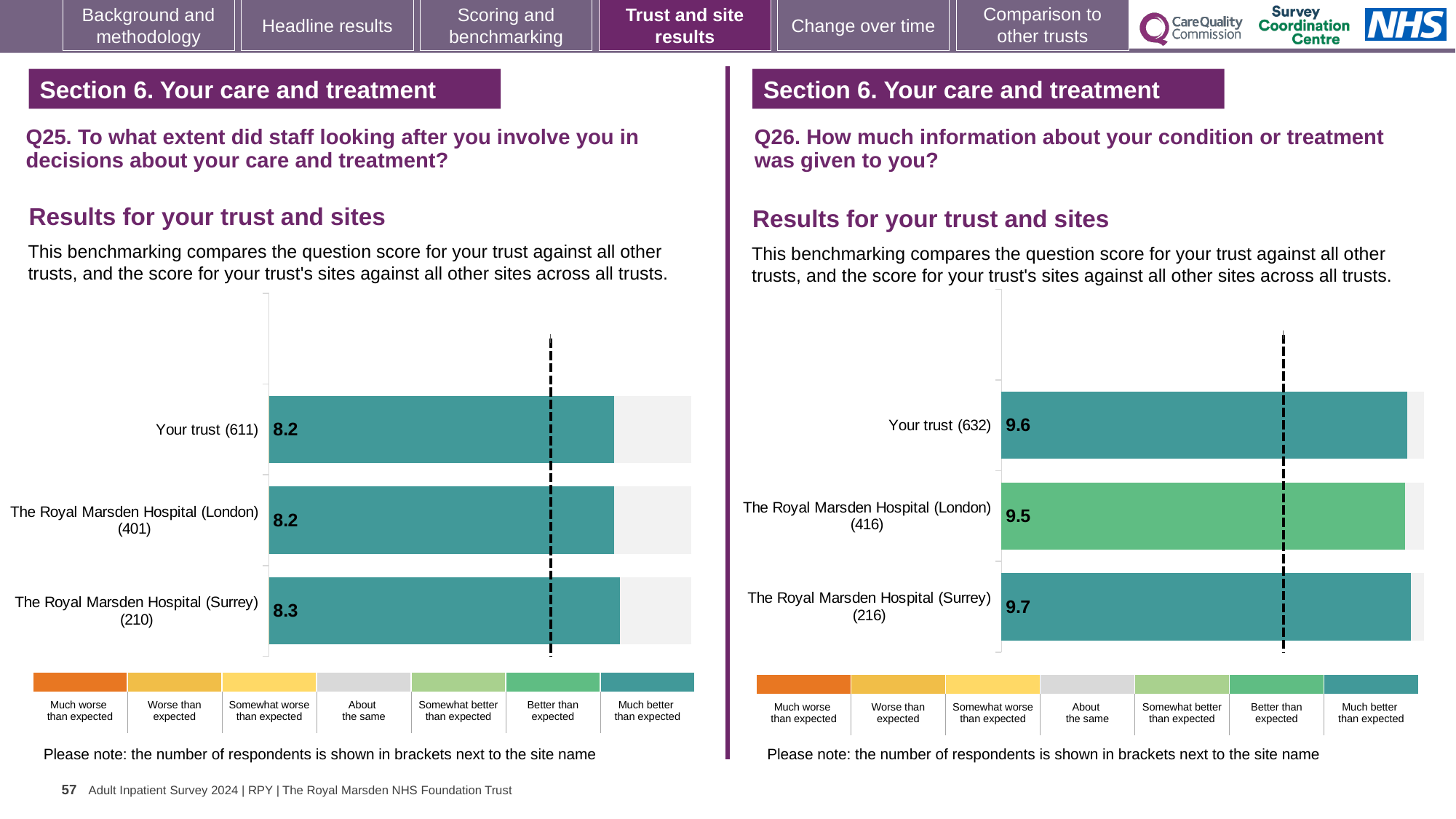
In the Q25 chart on the left, what is the score for Your trust (611)? 8.2 In the Q25 chart on the left, which has the higher score: The Royal Marsden Hospital (Surrey) or The Royal Marsden Hospital (London)? The Royal Marsden Hospital (Surrey) In the Q26 chart on the right, what is the score for Your trust (632)? 9.6 In the Q25 chart on the left, what is the difference between the scores for The Royal Marsden Hospital (Surrey) and Your trust? 0.1 In the Q26 chart on the right, what is the score for The Royal Marsden Hospital (London) (416)? 9.5 What type of chart is used for the Q26 results on the right? Bar chart In the Q25 chart on the left, what is the score for The Royal Marsden Hospital (Surrey) (210)? 8.3 In the Q26 chart on the right, which site or trust has the highest score? The Royal Marsden Hospital (Surrey) (216) In the Q26 chart on the right, which benchmark category does the colour of The Royal Marsden Hospital (London) bar correspond to? Better than expected In the Q26 chart on the right, which site or trust has the lowest score? The Royal Marsden Hospital (London) (416) In the Q26 chart on the right, what is the difference between the scores for The Royal Marsden Hospital (Surrey) and The Royal Marsden Hospital (London)? 0.2 How many bars are shown in the Q25 chart on the left? 3